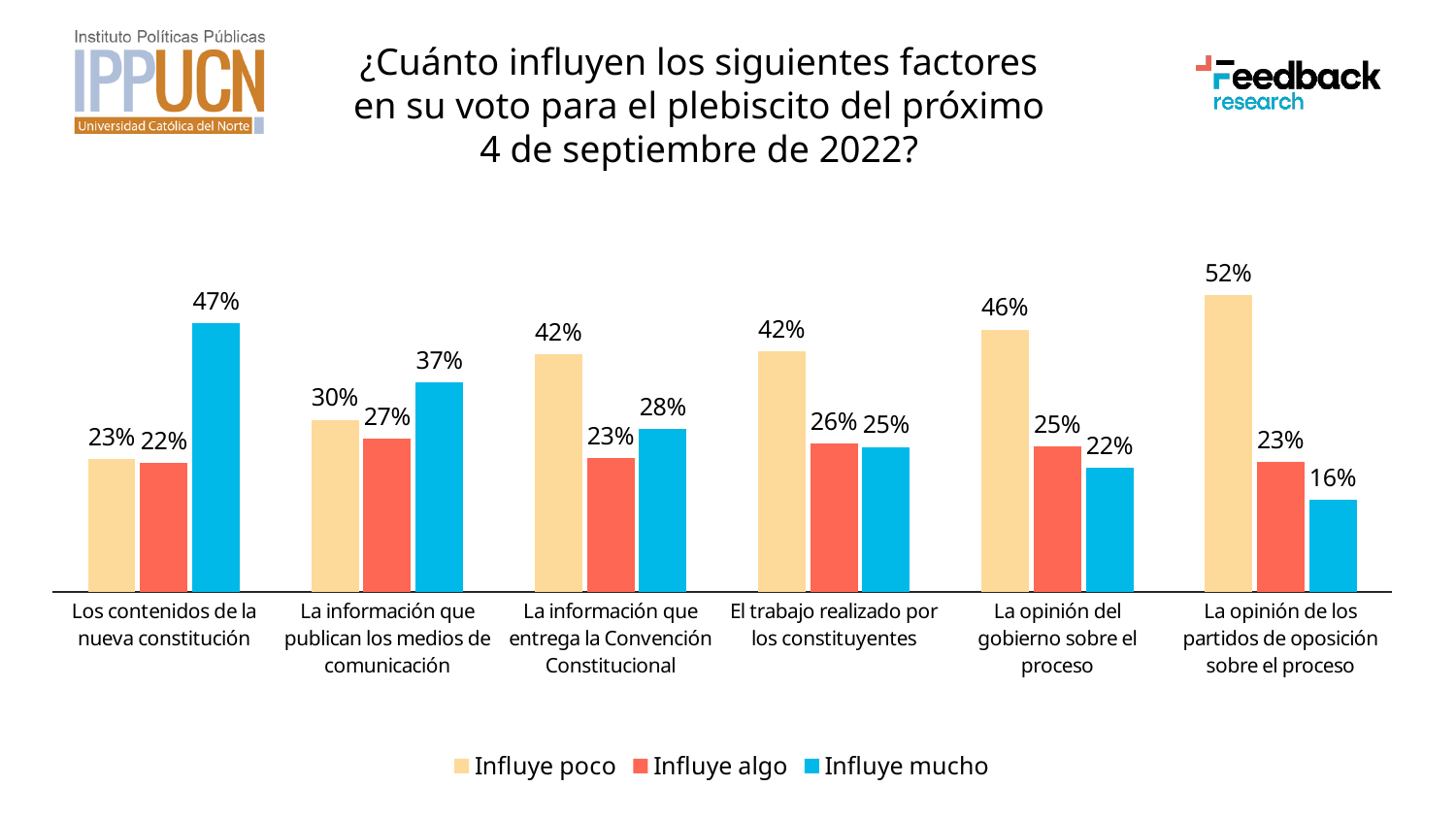
What is the value of "Influye mucho" for "Los contenidos de la nueva constitución"? 47% Which is larger for "La información que entrega la Convención Constitucional": "Influye poco" or "Influye mucho"? Influye poco Which category has the highest "Influye mucho" value? Los contenidos de la nueva constitución What is the value of "Influye algo" for "La información que publican los medios de comunicación"? 27% Which legend entry is shown in blue? Influye mucho What is the difference between "Influye poco" and "Influye mucho" for "La opinión de los partidos de oposición sobre el proceso"? 36% Does the "Influye poco" series rise or fall from left to right across the categories? Rise Which category has the lowest "Influye mucho" value? La opinión de los partidos de oposición sobre el proceso What is the value of "Influye poco" for "La opinión de los partidos de oposición sobre el proceso"? 52% How many series does the legend list? 3 What kind of chart is shown on the slide? Bar chart How many categories are shown on the x axis? 6